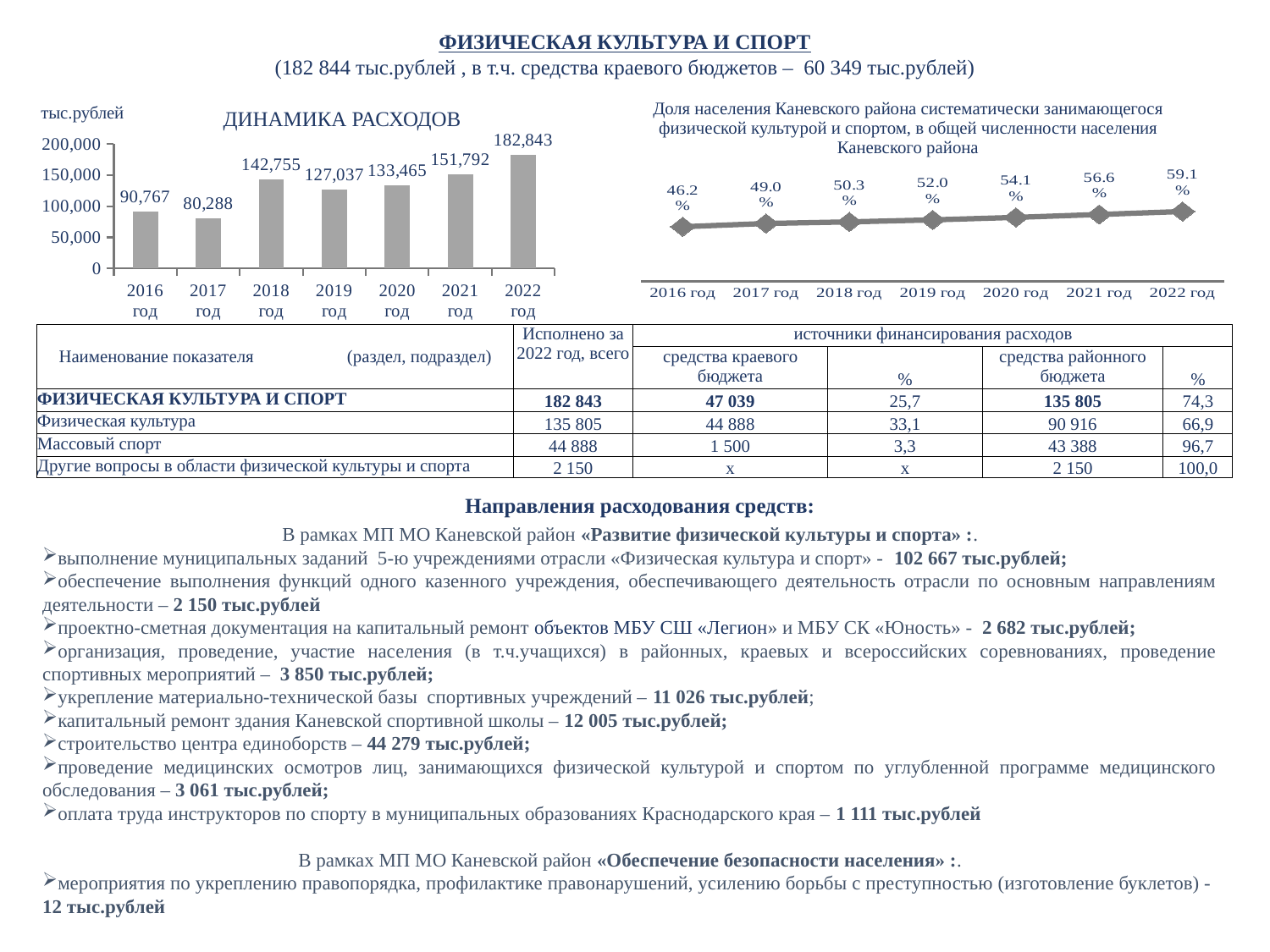
In the chart "ДИНАМИКА РАСХОДОВ", which year has the lowest value? 2017 год In the line chart on the right (Доля населения Каневского района...), what is the difference between the values for 2022 год and 2016 год? 12.9% In the chart "ДИНАМИКА РАСХОДОВ", how many years are shown on the x axis? 7 In the chart "ДИНАМИКА РАСХОДОВ", what is the value for 2017 год? 80,288 In the chart "ДИНАМИКА РАСХОДОВ", which is larger, the value for 2018 год or the value for 2019 год? 2018 год In the chart "ДИНАМИКА РАСХОДОВ", which year has the highest value? 2022 год In the line chart on the right (Доля населения Каневского района...), what is the value for 2016 год? 46.2% In the chart "ДИНАМИКА РАСХОДОВ", what is the value for 2022 год? 182,843 In the chart "ДИНАМИКА РАСХОДОВ", what is the difference between the values for 2022 год and 2021 год? 31,051 In the line chart on the right (Доля населения Каневского района...), what is the value for 2022 год? 59.1% What kind of chart is "ДИНАМИКА РАСХОДОВ"? bar chart In the line chart on the right (Доля населения Каневского района...), do the values rise or fall from 2016 год to 2022 год? rise